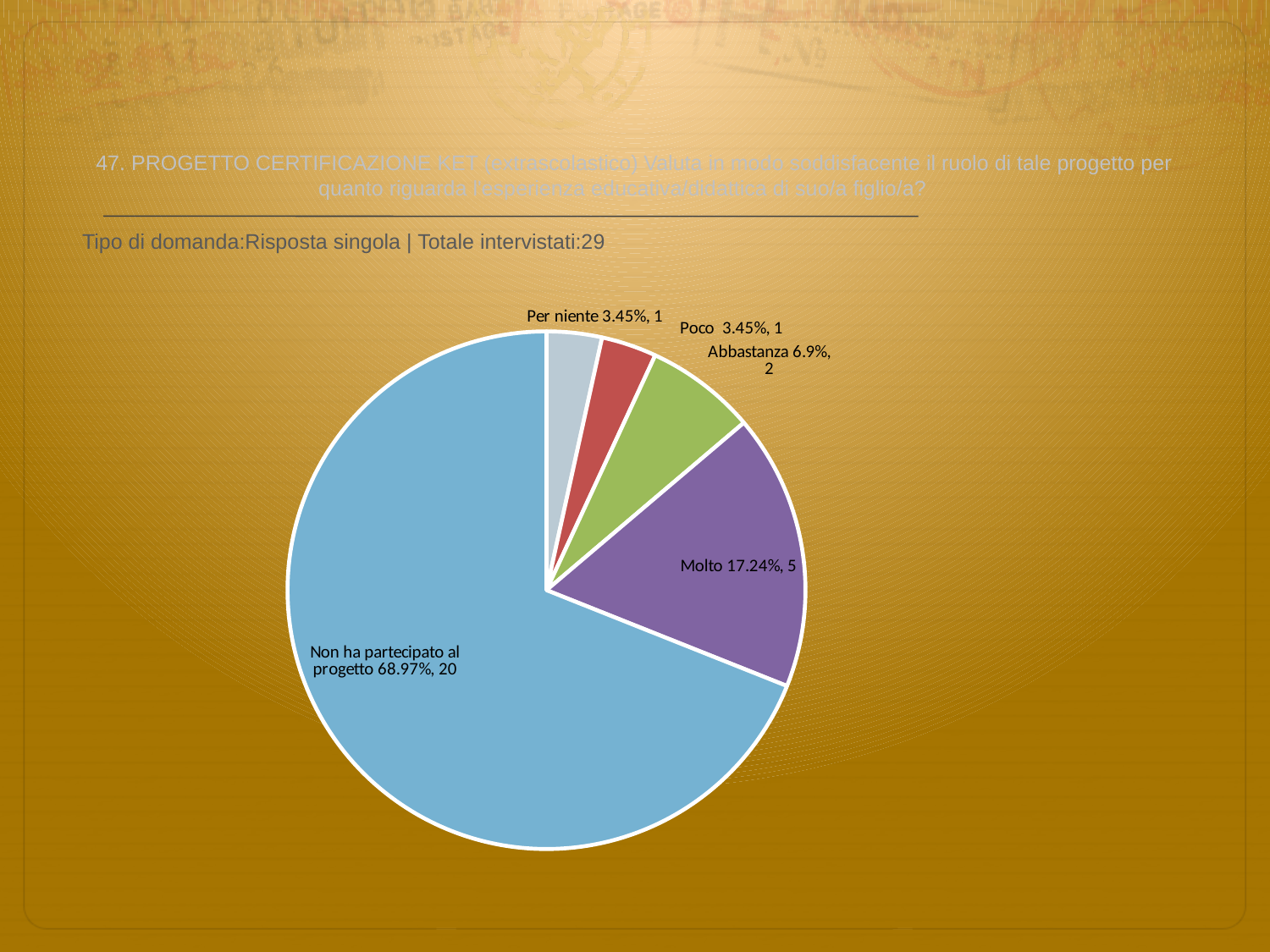
What percentage is shown for 'Per niente'? 3.45% What is the difference in respondent count between 'Non ha partecipato al progetto' and 'Molto'? 15 What colour is the 'Molto' slice? purple How many respondents chose 'Poco'? 1 How many respondents chose 'Molto'? 5 What percentage share does the 'Non ha partecipato al progetto' slice have? 68.97% What is the total number of respondents stated on the slide? 29 Which is larger, the 'Molto' slice or the 'Abbastanza' slice? Molto What percentage is shown for 'Abbastanza'? 6.9% What kind of chart is shown on the slide? pie chart Which category has the largest slice? Non ha partecipato al progetto How many slices does the pie chart have? 5